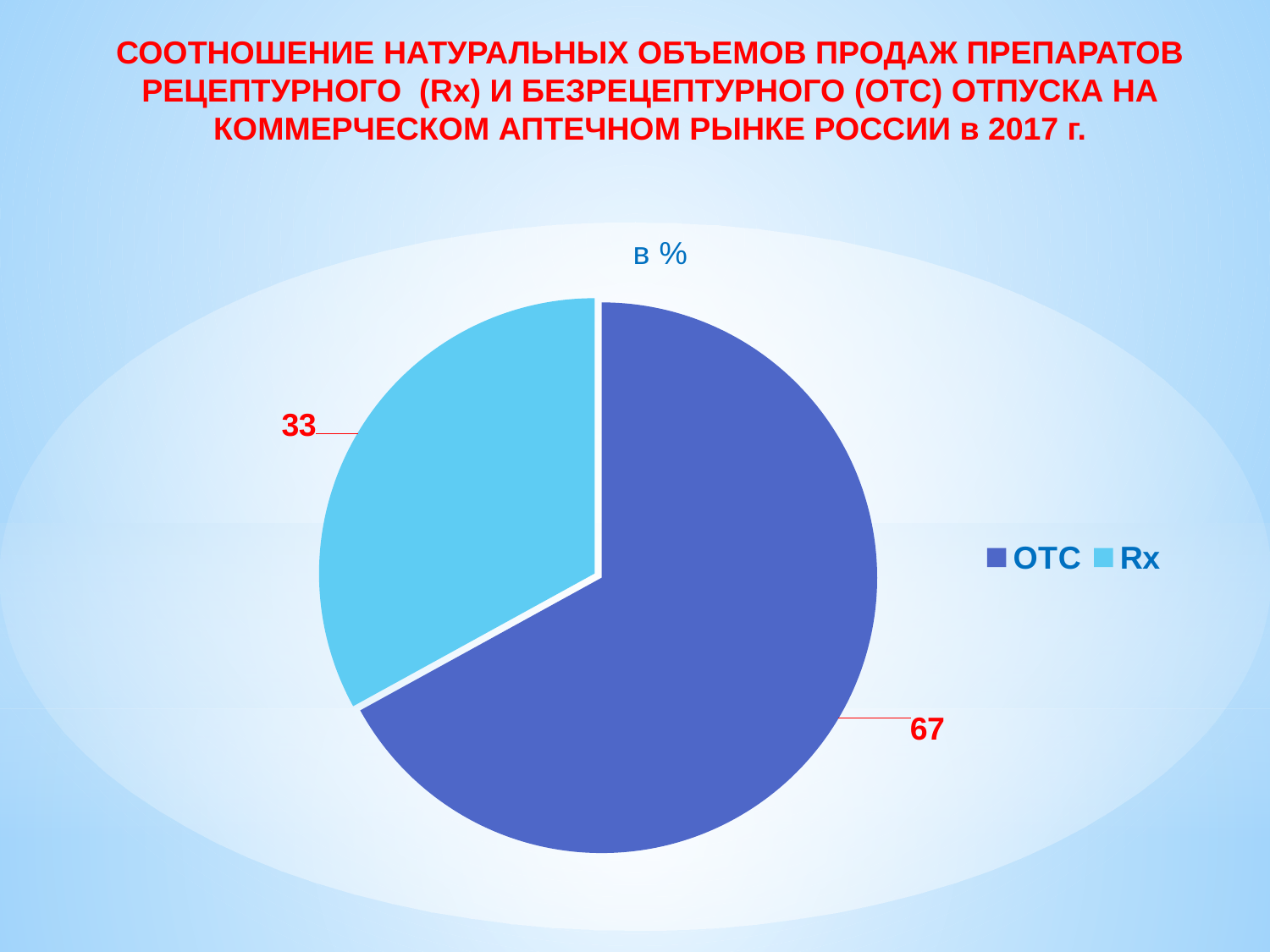
What is the chart's title? в % How many entries does the legend list? 2 What is the value for Rx? 33 What is the value for OTC? 67 Which is larger, OTC or Rx? OTC What is the difference between the OTC and Rx values? 34 Which category has the largest slice? OTC Which category has the smallest slice? Rx What colour is the OTC slice? dark blue What share of the pie does the Rx slice represent? 33% How many slices does the pie chart have? 2 What kind of chart is shown on the slide? pie chart